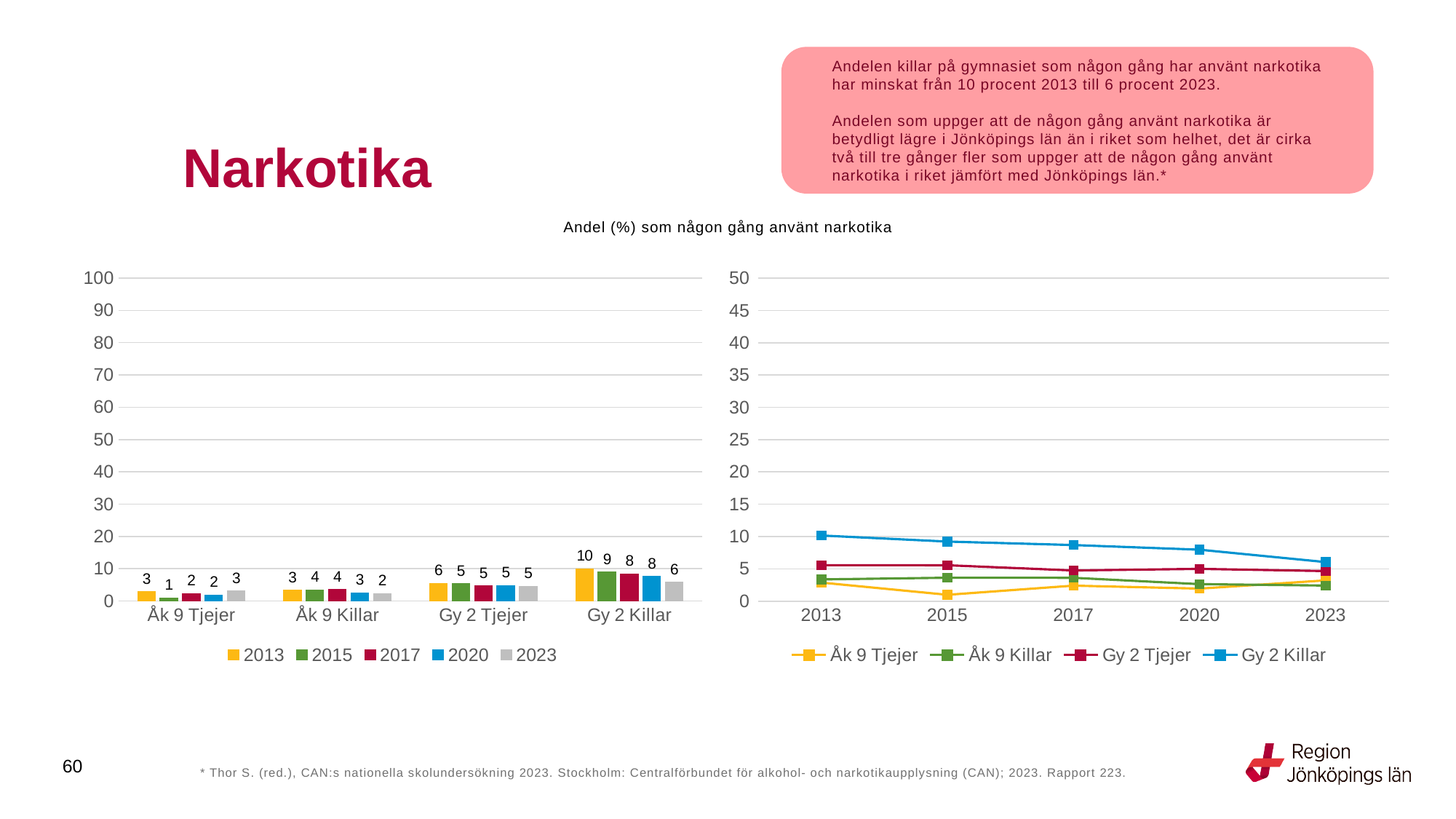
In the left bar chart, what is the value for Gy 2 Killar in 2013? 10 In the left bar chart, which category has the highest value for 2013? Gy 2 Killar In the left bar chart, what is the difference between the 2013 and 2023 values for Gy 2 Killar? 4 In the right line chart, does the Gy 2 Killar line rise or fall from 2013 to 2023? Fall In the left bar chart, what is the value for Åk 9 Tjejer in 2015? 1 In the left bar chart, which is larger: the 2015 value for Åk 9 Killar or the 2015 value for Gy 2 Tjejer? Gy 2 Tjejer In the left bar chart, which category has the lowest value for 2015? Åk 9 Tjejer In the left bar chart, what is the value for Gy 2 Tjejer in 2023? 5 How many categories are shown on the x axis of the left bar chart? 4 How many series does the legend of the left bar chart list? 5 In the right line chart, is the value for Gy 2 Killar in 2013 greater or less than 5? greater What kind of chart is the chart on the right of the slide? Line chart